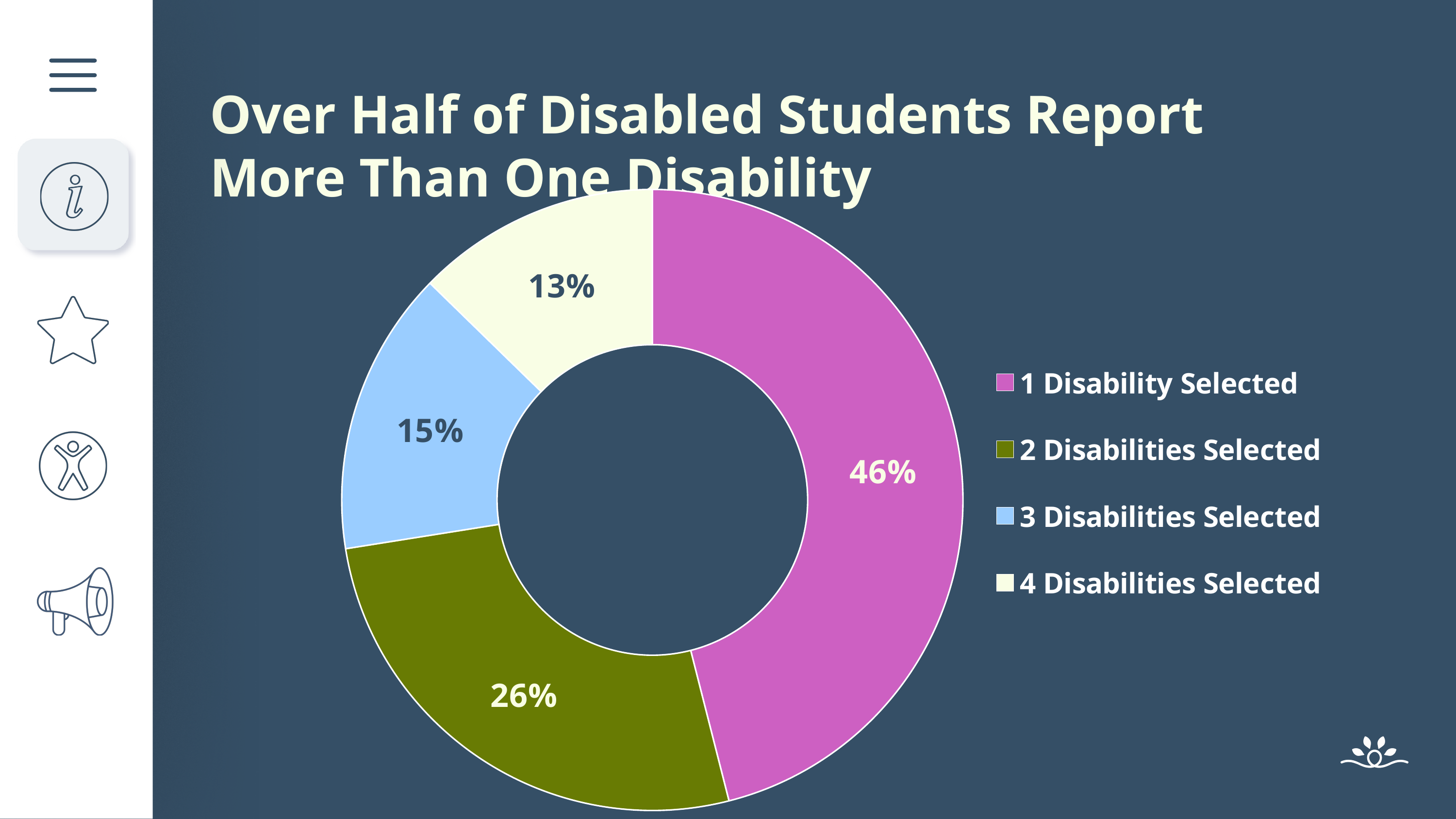
What kind of chart is shown on the slide? Pie chart (doughnut) What percentage of students selected 1 disability? 46% How many categories does the chart show? 4 Which is larger: the share for 3 Disabilities Selected or 4 Disabilities Selected? 3 Disabilities Selected What percentage of students selected 4 disabilities? 13% Which category has the smallest share of the chart? 4 Disabilities Selected What is the title of the slide? Over Half of Disabled Students Report More Than One Disability What is the difference in percentage points between 1 Disability Selected and 2 Disabilities Selected? 20 What percentage of students selected 3 disabilities? 15% Which category has the largest share of the chart? 1 Disability Selected What colour is the slice for 2 Disabilities Selected? Green What percentage of students selected 2 disabilities? 26%